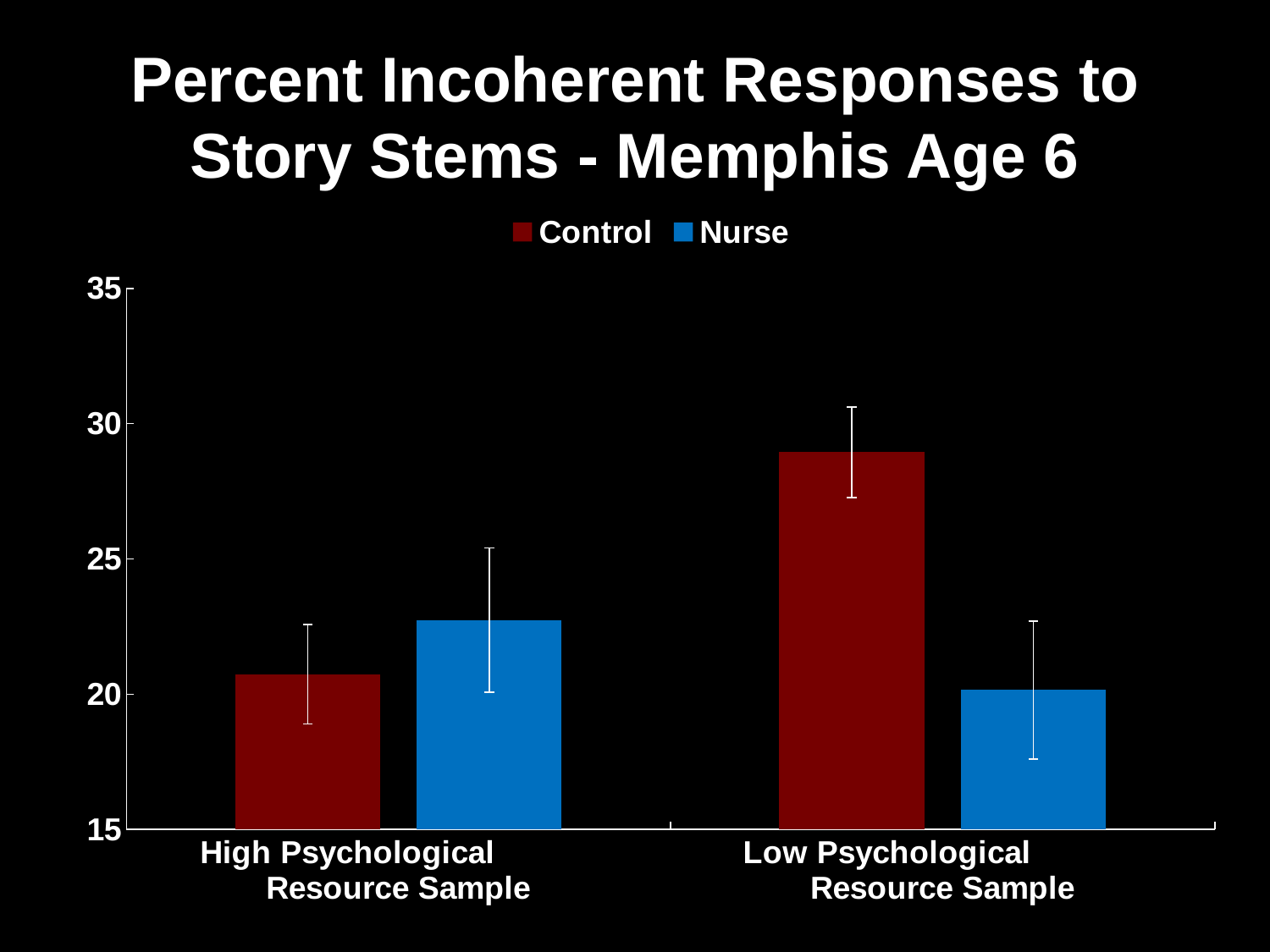
In the High Psychological Resource Sample, which is larger, Control or Nurse? Nurse How many categories are shown on the x axis? 2 Is the value for Control in the Low Psychological Resource Sample greater or less than 25? greater Is the value for Control in the High Psychological Resource Sample greater or less than 25? less Is the value for Nurse in the High Psychological Resource Sample greater or less than 25? less What is the title of the chart? Percent Incoherent Responses to Story Stems - Memphis Age 6 What kind of chart is shown on the slide? bar chart Which colour represents the Nurse series in the legend? blue Which bar is the highest in the chart? Control, Low Psychological Resource Sample In the Low Psychological Resource Sample, which is larger, Control or Nurse? Control How many series does the legend list? 2